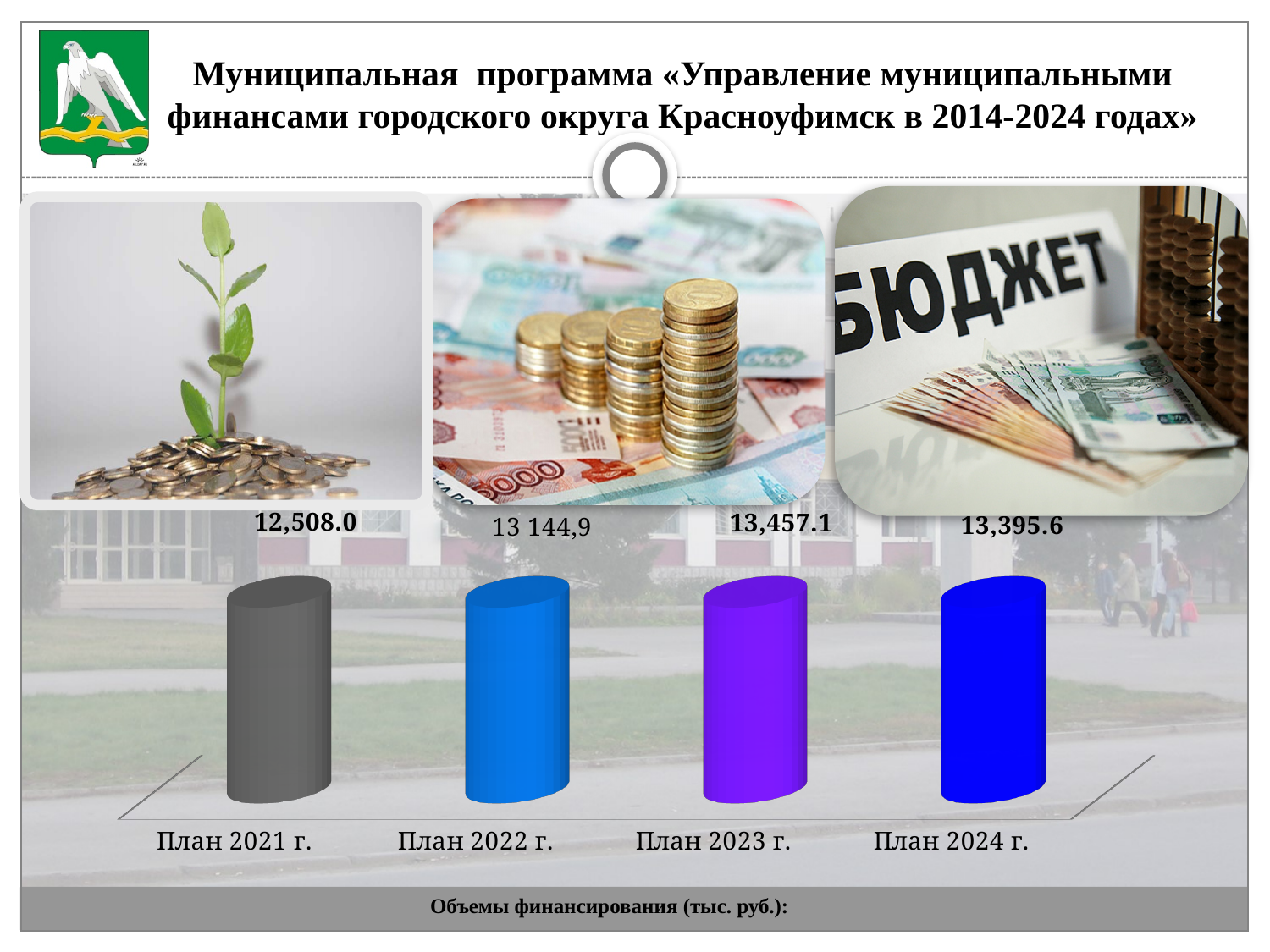
What kind of chart is shown on the slide? Bar chart What unit is given in the caption below the chart? тыс. руб. What is the value for План 2022 г.? 13 144,9 What is the difference between the values for План 2023 г. and План 2021 г.? 949.1 What is the difference between the values for План 2023 г. and План 2024 г.? 61.5 What is the value for План 2021 г.? 12,508.0 Which category has the lowest value? План 2021 г. Which category has the highest value? План 2023 г. What is the value for План 2023 г.? 13,457.1 Which is larger, the value for План 2022 г. or the value for План 2021 г.? План 2022 г. What is the value for План 2024 г.? 13,395.6 How many categories are shown in the chart? 4